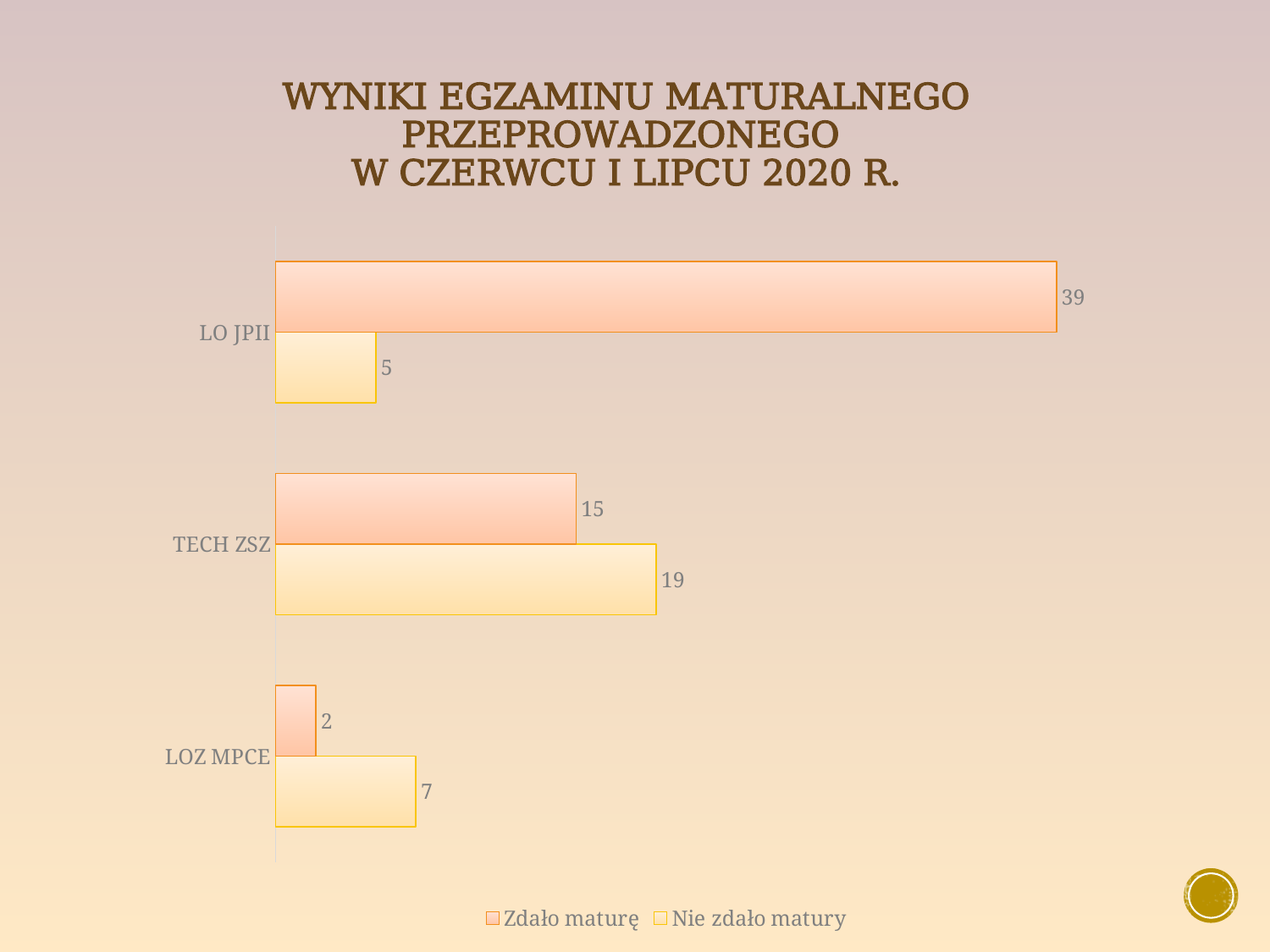
Which category has the lowest value for 'Nie zdało matury'? LO JPII What is the total of 'Zdało maturę' and 'Nie zdało matury' for LO JPII? 44 What is the value of 'Zdało maturę' for LOZ MPCE? 2 Which is larger for LOZ MPCE: 'Zdało maturę' or 'Nie zdało matury'? Nie zdało matury How many series does the legend list? 2 What is the value of 'Nie zdało matury' for LO JPII? 5 What is the difference between 'Zdało maturę' and 'Nie zdało matury' for TECH ZSZ? 4 What kind of chart is shown on the slide? Bar chart What is the value of 'Zdało maturę' for LO JPII? 39 Which category has the highest value for 'Zdało maturę'? LO JPII What is the value of 'Nie zdało matury' for TECH ZSZ? 19 How many categories are shown on the chart? 3